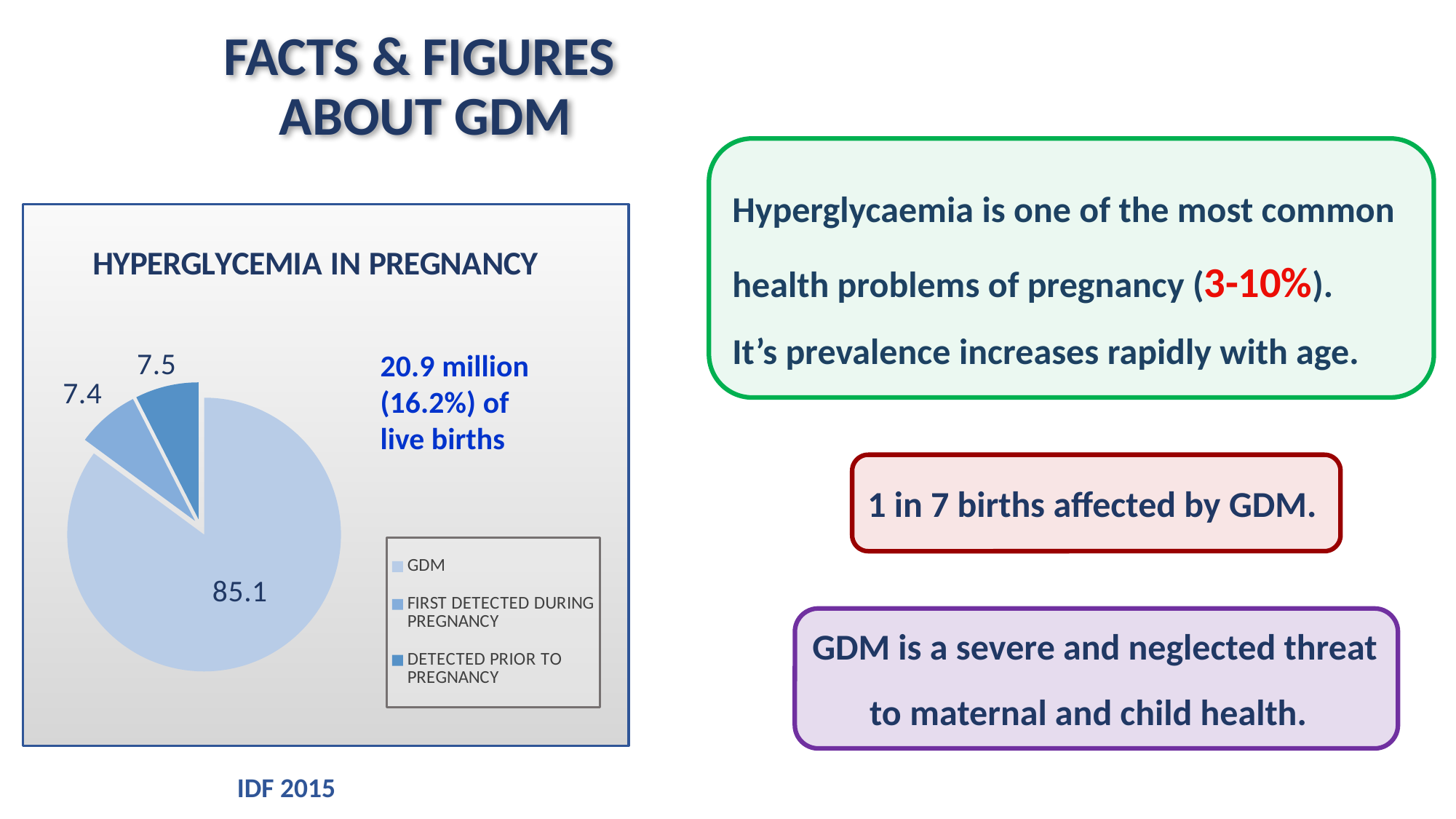
What is the value of the FIRST DETECTED DURING PREGNANCY slice? 7.4 How many slices does the pie chart have? 3 What is the value of the GDM slice? 85.1 What is the title of the chart? HYPERGLYCEMIA IN PREGNANCY Which category has the largest slice of the pie? GDM What is the difference between the GDM value and the FIRST DETECTED DURING PREGNANCY value? 77.7 How many entries does the chart legend list? 3 Which is larger, the GDM slice or the DETECTED PRIOR TO PREGNANCY slice? GDM What kind of chart is shown on the slide? pie chart What is the value of the DETECTED PRIOR TO PREGNANCY slice? 7.5 What is the difference between the GDM value and the DETECTED PRIOR TO PREGNANCY value? 77.6 What is the total of the three values shown on the pie chart? 100